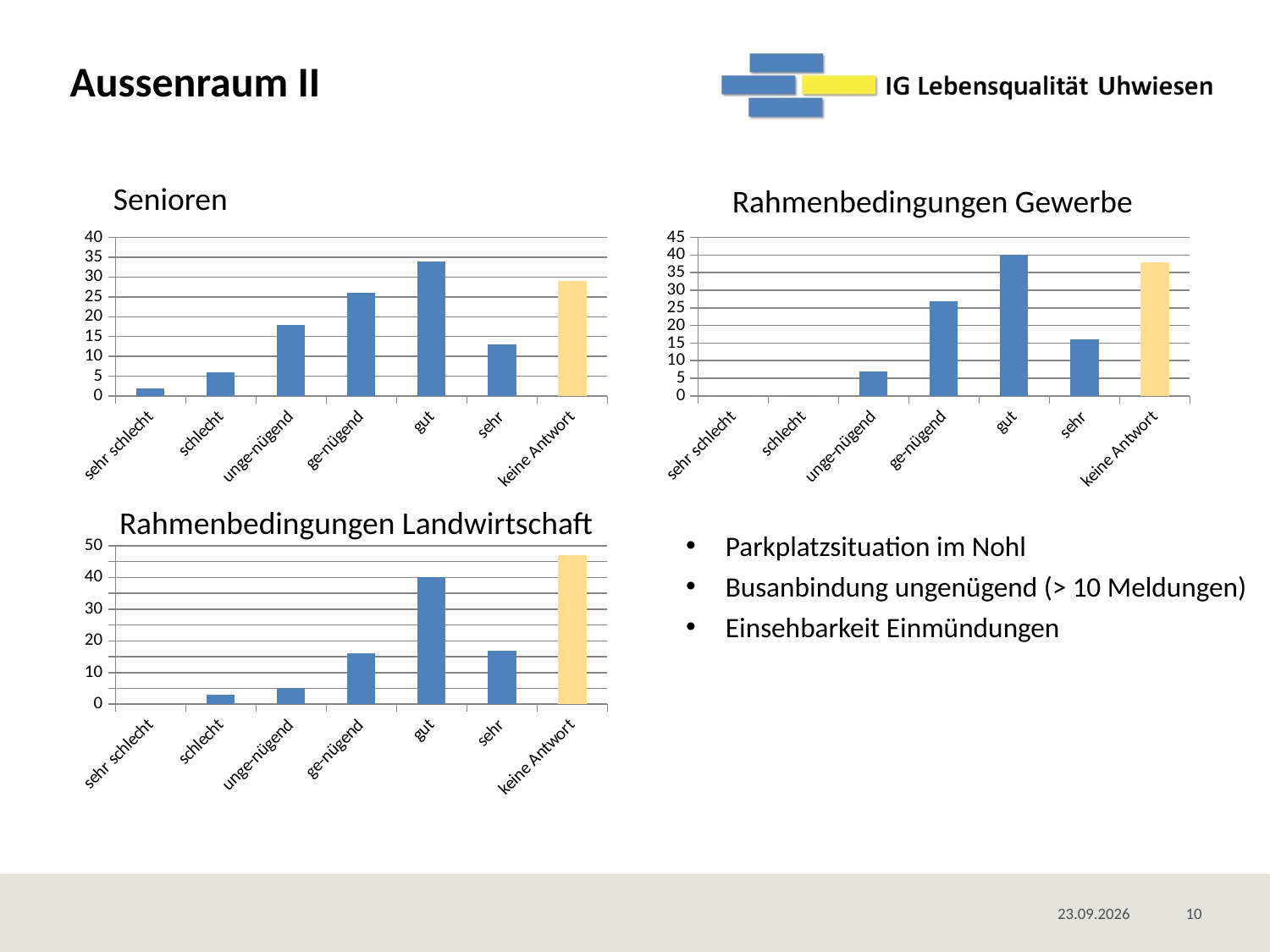
In the Senioren chart, which category has the highest value? gut In the Senioren chart, which is larger, the value for unge-nügend or the value for sehr? unge-nügend In the Rahmenbedingungen Landwirtschaft chart, is the value for gut greater or less than 30? greater What kind of chart is the Rahmenbedingungen Landwirtschaft chart? bar chart In the Rahmenbedingungen Gewerbe chart, which is larger, the value for gut or the value for sehr? gut In the Rahmenbedingungen Gewerbe chart, is the value for unge-nügend greater or less than 10? less In the Senioren chart, is the value for ge-nügend greater or less than 20? greater In the Senioren chart, which category has the lowest value? sehr schlecht How many categories are shown on the x axis of the Senioren chart? 7 In the Rahmenbedingungen Landwirtschaft chart, which category has the highest value? keine Antwort